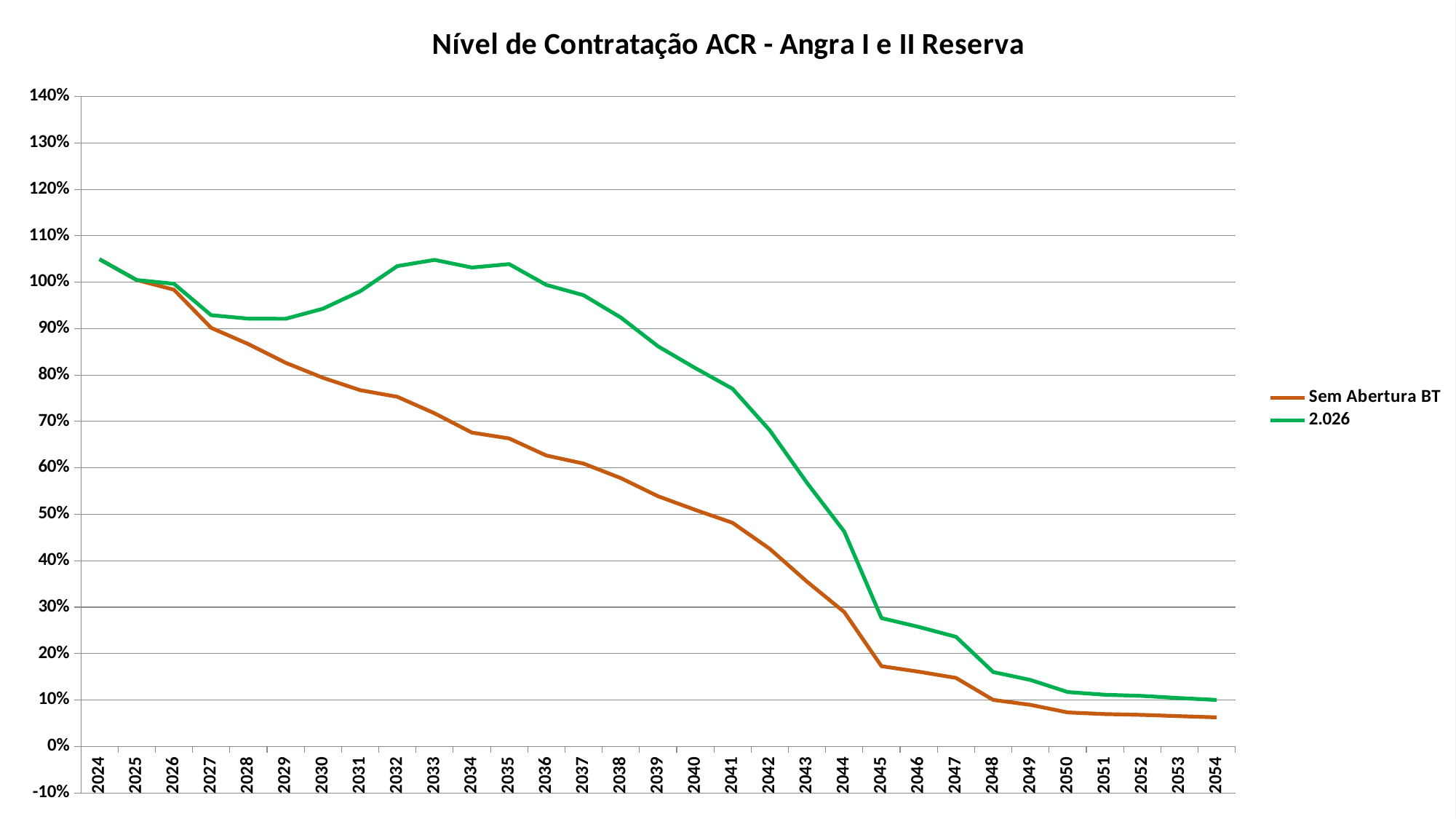
What is the title of the chart? Nível de Contratação ACR - Angra I e II Reserva In which year is the Sem Abertura BT series at its lowest? 2054 What are the two series named in the legend? Sem Abertura BT and 2.026 Is the value for Sem Abertura BT in 2050 greater or less than 10%? less In 2035, which series has the higher value, Sem Abertura BT or 2.026? 2.026 How many series does the legend list? 2 Is the value for 2.026 in 2033 greater or less than 100%? greater How many years are shown on the x axis? 31 Is the value for Sem Abertura BT in 2041 greater or less than 50%? less What kind of chart is shown on the slide? line chart Do the values for Sem Abertura BT rise or fall from 2024 to 2054? fall